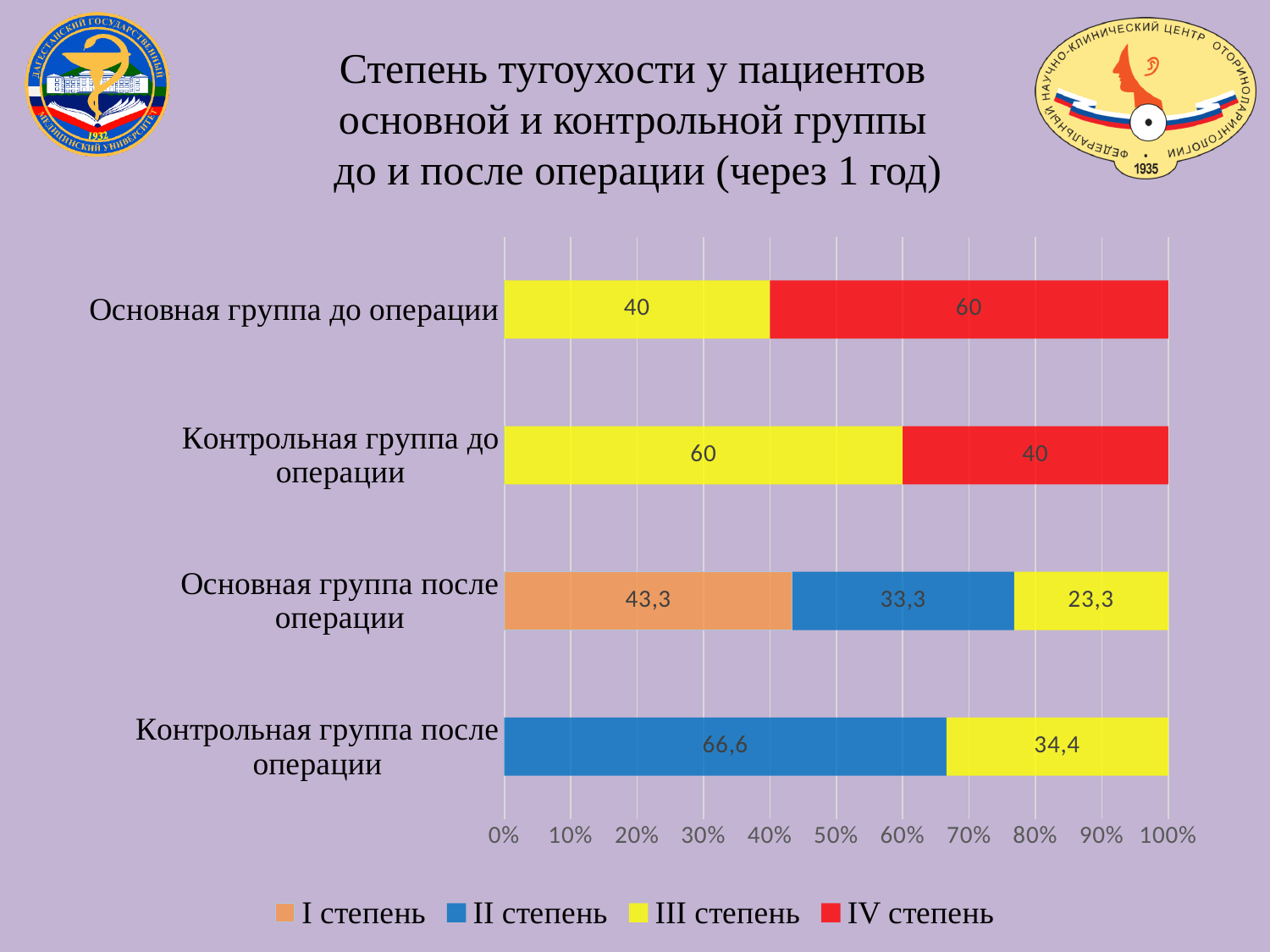
Which is larger: the III степень value for Контрольная группа после операции or for Основная группа после операции? Контрольная группа после операции How many categories (groups) are plotted on the chart? 4 Which category has the highest value for IV степень? Основная группа до операции What is the value of III степень for Основная группа после операции? 23,3 What is the value of II степень for Контрольная группа после операции? 66,6 Which legend entry is shown in red? IV степень What is the value of III степень for Контрольная группа до операции? 60 What is the difference between the II степень values for Контрольная группа после операции and Основная группа после операции? 33,3 What is the value of IV степень for Основная группа до операции? 60 How many series does the legend list? 4 What type of chart is shown on the slide? Stacked bar chart What is the value of I степень for Основная группа после операции? 43,3